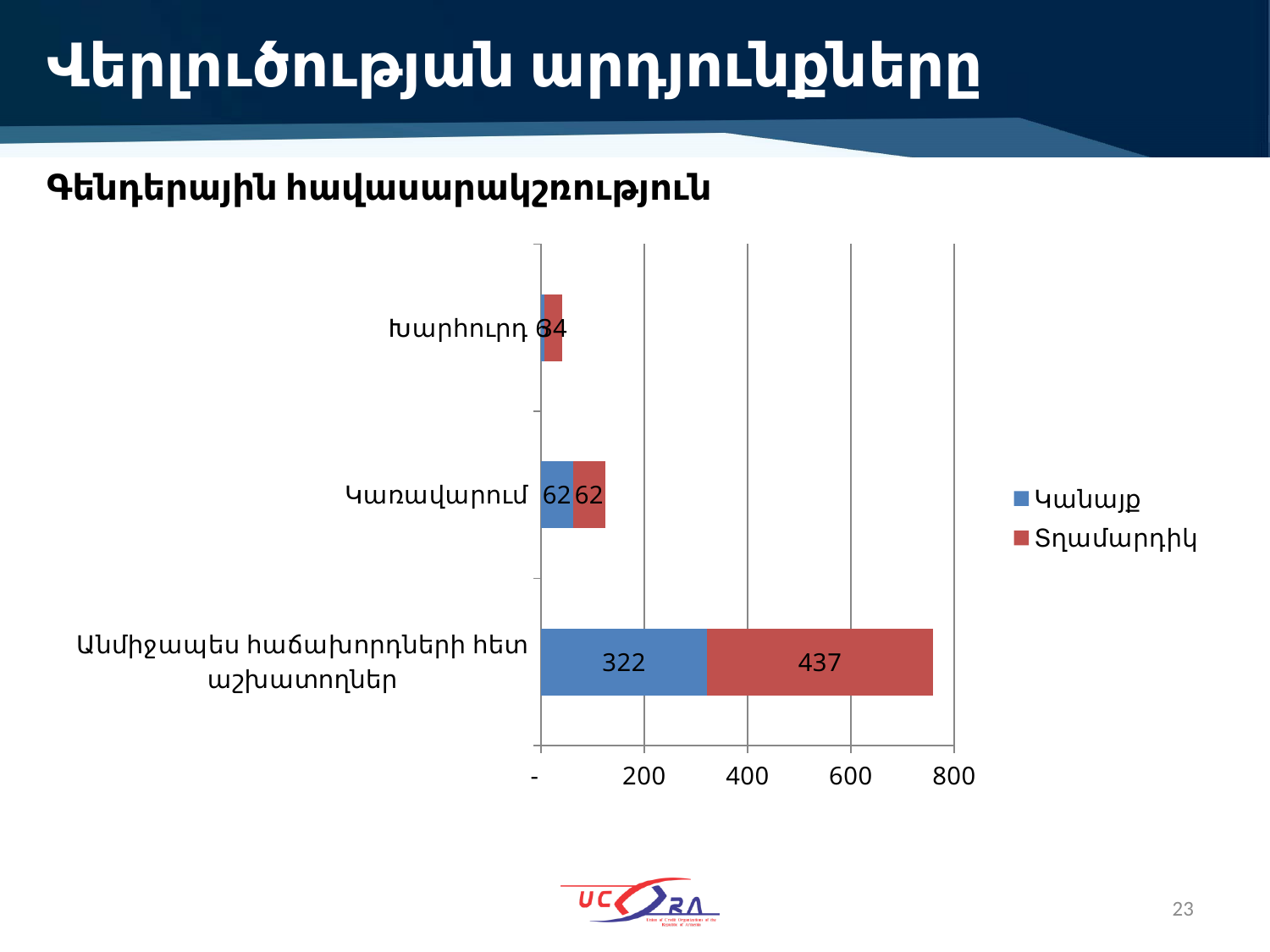
Is the total value for Խորհուրդ greater or less than 200? less Which category has the longest total bar? Անմիջապես հաճախորդների հետ աշխատողներ How many categories are shown on the chart? 3 What is the value for Տղամարդիկ in the Անմիջապես հաճախորդների հետ աշխատողներ category? 437 In the Անմիջապես հաճախորդների հետ աշխատողներ category, which series has the larger value, Կանայք or Տղամարդիկ? Տղամարդիկ What is the total of the stacked bar for Անմիջապես հաճախորդների հետ աշխատողներ? 759 What kind of chart is shown on the slide? bar chart What is the difference between the Տղամարդիկ and Կանայք values for Անմիջապես հաճախորդների հետ աշխատողներ? 115 How many series does the legend list? 2 What is the value for Կանայք in the Անմիջապես հաճախորդների հետ աշխատողներ category? 322 What is the total of the stacked bar for Կառավարում? 124 What is the value for Կանայք in the Կառավարում category? 62